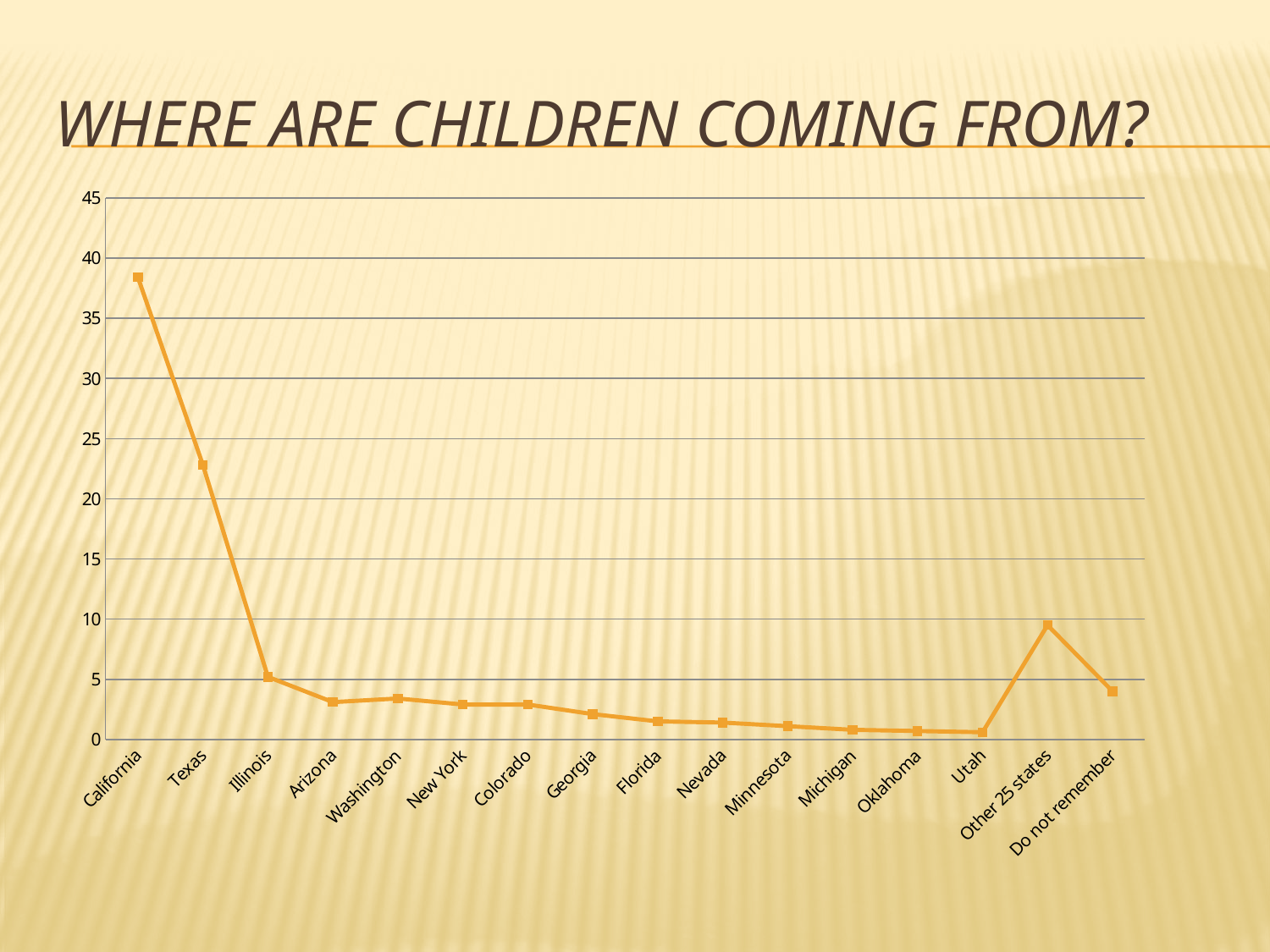
Which is larger, the value for Other 25 states or the value for Illinois? Other 25 states Do the values rise or fall along the x axis from California to Utah? fall Is the value for Other 25 states greater or less than 10? less How many categories are plotted along the x axis? 16 Is the value for Texas greater or less than 25? less Which is larger, the value for California or the value for Texas? California Which category has the highest value? California What is the title of the chart on the slide? WHERE ARE CHILDREN COMING FROM? What kind of chart is shown on the slide? line chart Is the value for Texas greater or less than 20? greater